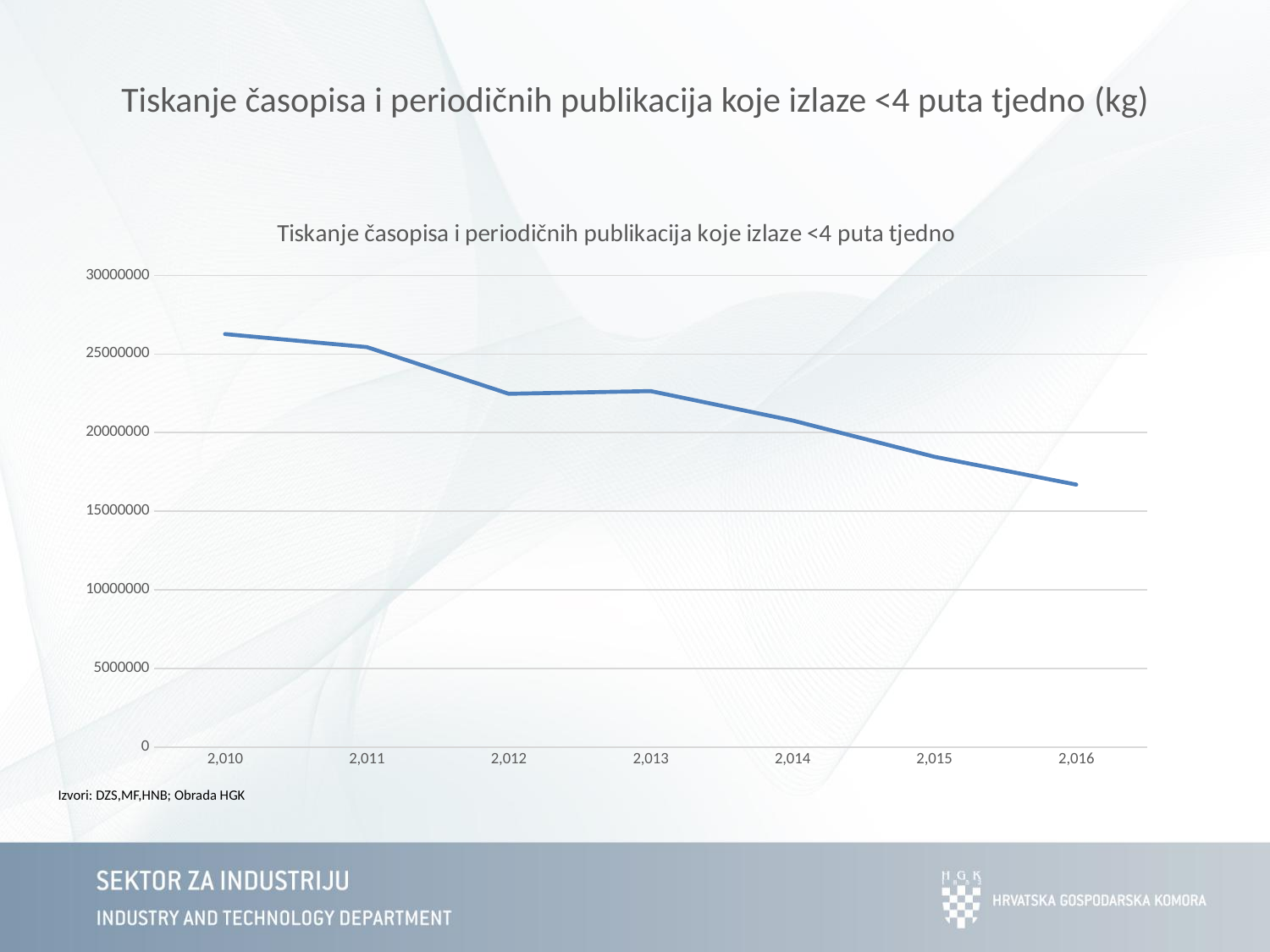
Which year has the highest value in the chart? 2010 How many years are plotted along the x axis of the chart? 7 Is the value for 2012 greater or less than 25000000? less Which year has the larger value, 2011 or 2015? 2011 Is the value for 2010 greater or less than 25000000? greater What is the title of the chart? Tiskanje časopisa i periodičnih publikacija koje izlaze <4 puta tjedno Is the value for 2015 greater or less than 20000000? less Which year has the larger value, 2010 or 2016? 2010 Which year has the lowest value in the chart? 2016 What kind of chart is shown on the slide? line chart Do the values in the chart generally rise or fall from 2010 to 2016? fall